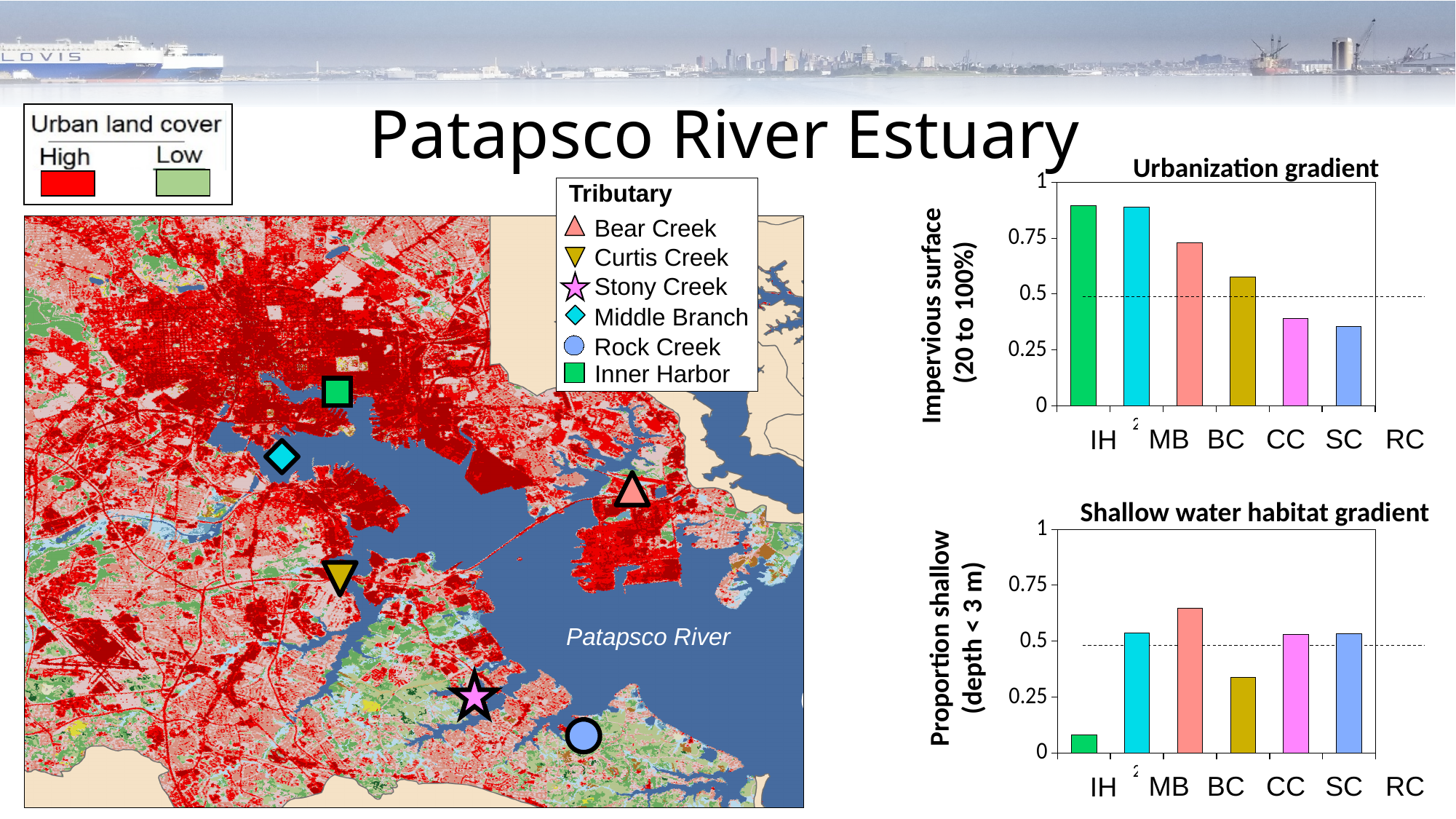
In the 'Shallow water habitat gradient' chart, which bar is the highest? The third (salmon) bar In the 'Urbanization gradient' chart, which is larger: the gold bar or the pink bar? The gold bar What is the title of the upper chart on the right of the slide? Urbanization gradient In the 'Shallow water habitat gradient' chart, which bar is the lowest? The first (green) bar In the 'Shallow water habitat gradient' chart, is the value of the gold bar greater or less than 0.5? less How many bars are plotted in the 'Urbanization gradient' chart? 6 In the 'Urbanization gradient' chart, do the bar values rise or fall from left to right? Fall What is the y-axis label of the 'Shallow water habitat gradient' chart? Proportion shallow (depth < 3 m) What kind of chart is the 'Urbanization gradient' chart? Bar chart In the 'Urbanization gradient' chart, is the value of the last (blue) bar greater or less than 0.5? less In the 'Shallow water habitat gradient' chart, is the value of the first (green) bar greater or less than 0.25? less